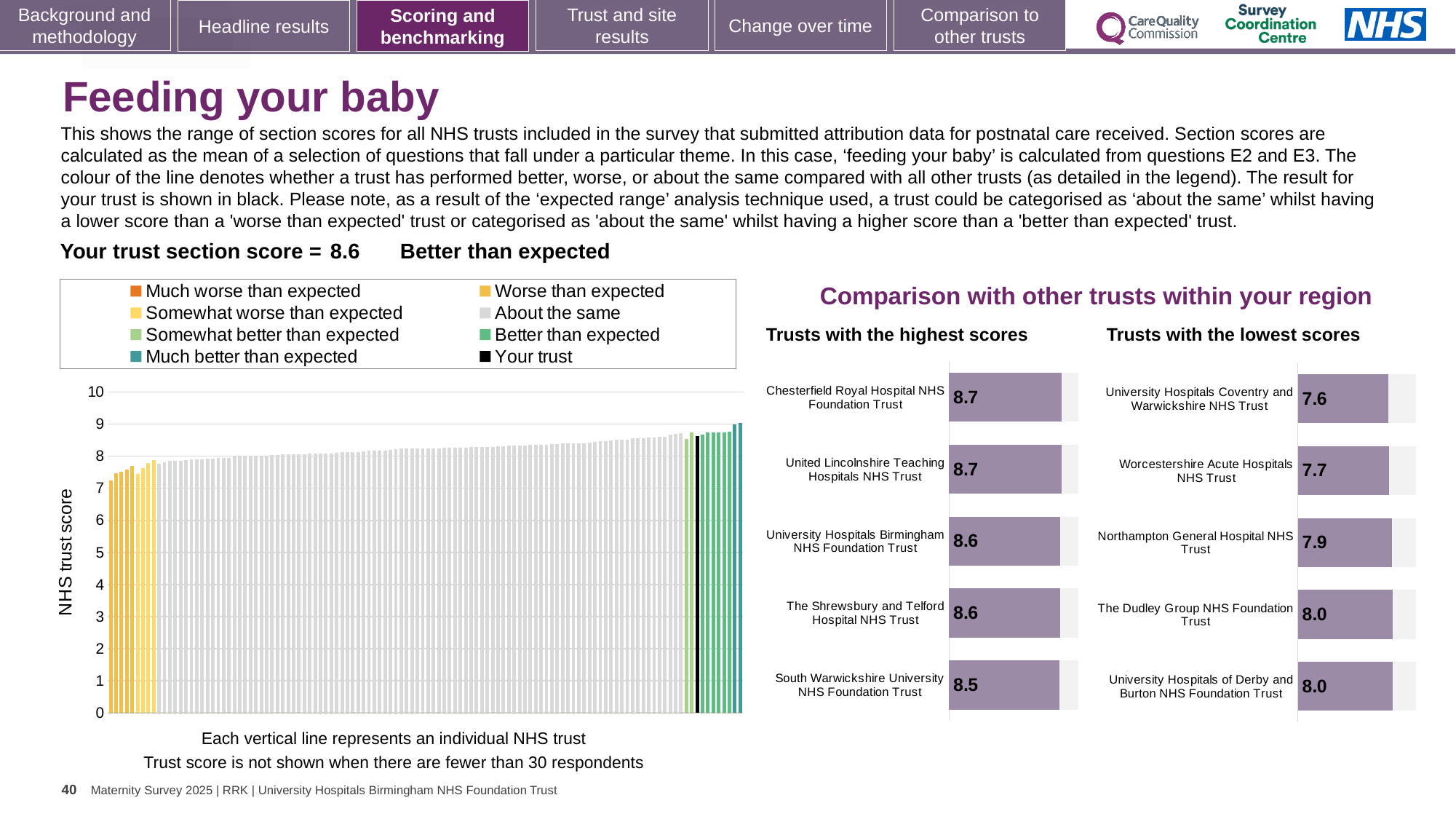
In the 'Trusts with the lowest scores' chart, which has the higher score: Northampton General Hospital NHS Trust or Worcestershire Acute Hospitals NHS Trust? Northampton General Hospital NHS Trust In the 'Trusts with the lowest scores' chart, what is the difference between the scores of University Hospitals of Derby and Burton NHS Foundation Trust and University Hospitals Coventry and Warwickshire NHS Trust? 0.4 In the 'Trusts with the lowest scores' chart, what is the score for University Hospitals Coventry and Warwickshire NHS Trust? 7.6 In the 'Trusts with the highest scores' chart, what is the score for Chesterfield Royal Hospital NHS Foundation Trust? 8.7 In the 'Trusts with the lowest scores' chart, which trust has the lowest score? University Hospitals Coventry and Warwickshire NHS Trust How many trusts are listed in the 'Trusts with the highest scores' chart? 5 In the 'Trusts with the highest scores' chart, which trust has the lowest score? South Warwickshire University NHS Foundation Trust What kind of chart is the main 'NHS trust score' chart on the left? Bar chart In the 'Trusts with the highest scores' chart, what is the difference between the scores of Chesterfield Royal Hospital NHS Foundation Trust and South Warwickshire University NHS Foundation Trust? 0.2 In the main 'NHS trust score' chart, is the value of the leftmost (lowest) bar greater or less than 7? greater In the main 'NHS trust score' chart, is the value for the black 'Your trust' bar greater or less than 8? greater How many entries does the legend above the main 'NHS trust score' chart list? 8